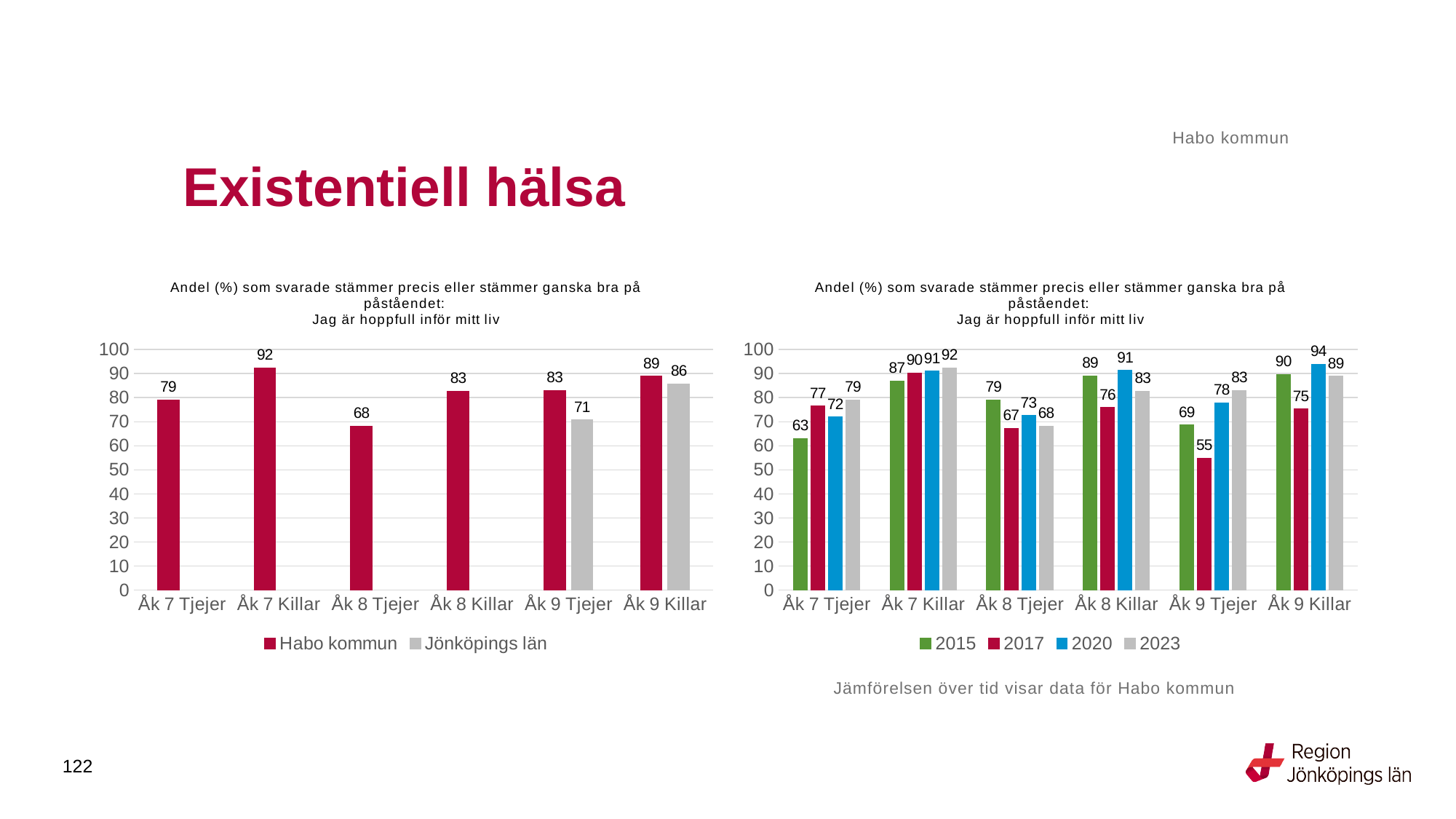
In the right chart, how many series does the legend list? 4 In the left chart, what is the value for Habo kommun for Åk 7 Killar? 92 What kind of chart is the right chart? Bar chart In the left chart, what is the difference between Habo kommun and Jönköpings län for Åk 9 Killar? 3 In the right chart, what is the value for 2017 for Åk 9 Tjejer? 55 In the left chart, which category has the lowest value for Habo kommun? Åk 8 Tjejer In the left chart, how many series does the legend list? 2 In the right chart, what is the value for 2020 for Åk 9 Killar? 94 In the right chart, which year has the highest value for Åk 7 Tjejer? 2023 In the left chart, what is the value for Jönköpings län for Åk 9 Tjejer? 71 In the right chart, what is the difference between the 2015 and 2017 values for Åk 8 Killar? 13 In the right chart, which is larger for Åk 8 Tjejer: the 2015 value or the 2023 value? 2015